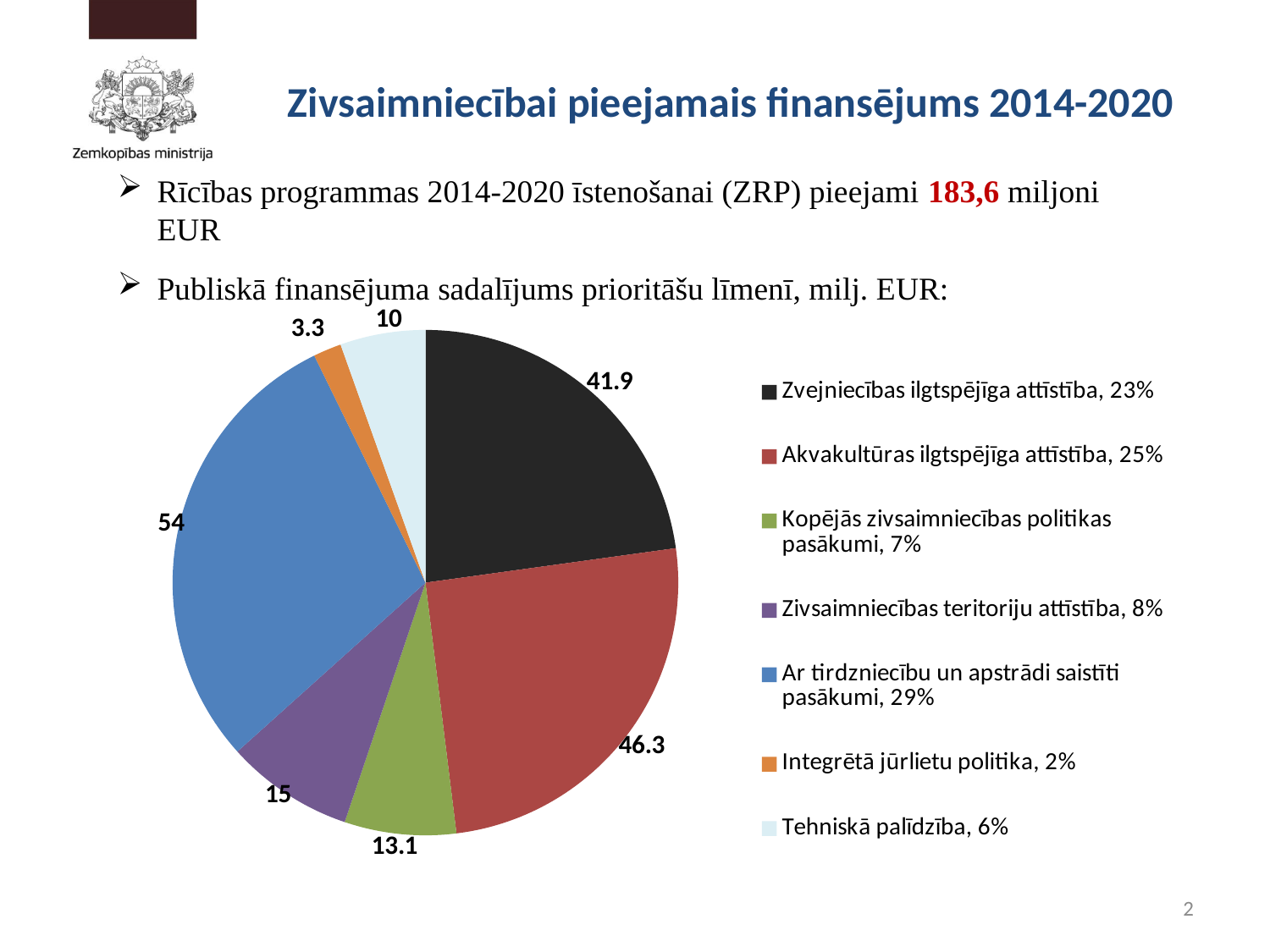
How many slices does the pie chart have? 7 Which category has the smallest slice of the pie? Integrētā jūrlietu politika What is the value for Tehniskā palīdzība? 10 Which is larger, the value for Akvakultūras ilgtspējīga attīstība or the value for Zvejniecības ilgtspējīga attīstība? Akvakultūras ilgtspējīga attīstība Which category has the largest slice of the pie? Ar tirdzniecību un apstrādi saistīti pasākumi What share of the pie does Kopējās zivsaimniecības politikas pasākumi represent, according to the legend? 7% What is the value for Integrētā jūrlietu politika? 3.3 What kind of chart is shown on the slide? pie chart What is the value for Zvejniecības ilgtspējīga attīstība? 41.9 What is the value for Akvakultūras ilgtspējīga attīstība? 46.3 What is the difference between the values for Ar tirdzniecību un apstrādi saistīti pasākumi and Zivsaimniecības teritoriju attīstība? 39 What colour is the slice for Zivsaimniecības teritoriju attīstība? purple